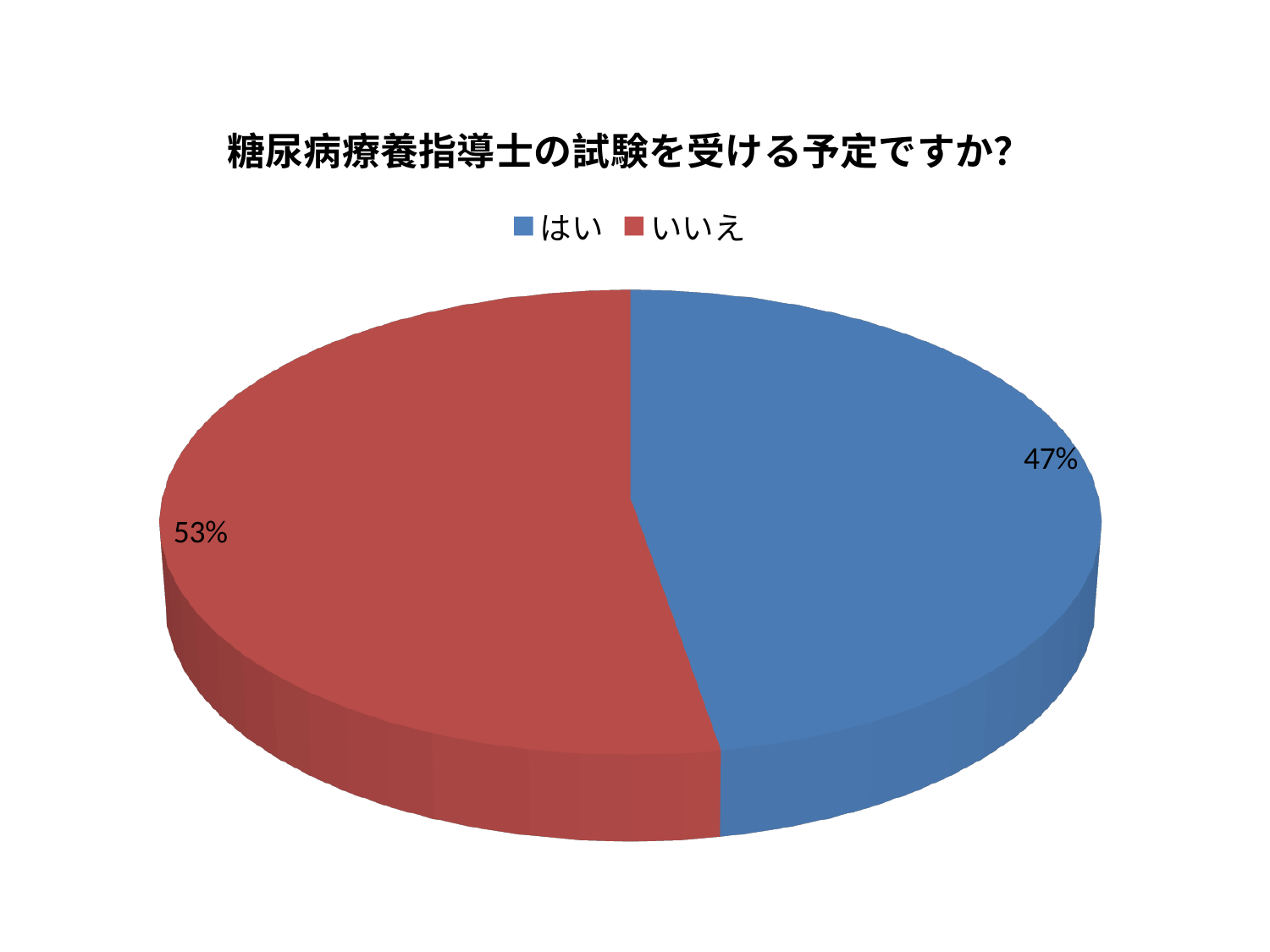
Which category has the largest share of the pie? いいえ Which category has the smallest share of the pie? はい Is the share for はい greater or less than 50%? less What is the title of the chart? 糖尿病療養指導士の試験を受ける予定ですか? How many categories are shown in the pie chart? 2 Is the share for いいえ greater or less than 50%? greater What share of the pie does いいえ (no) represent? 53% What kind of chart is shown on the slide? Pie chart Which is larger, the share for はい or the share for いいえ? いいえ What is the difference in percentage points between いいえ and はい? 6 percentage points What colour is the slice for はい? Blue What share of the pie does はい (yes) represent? 47%